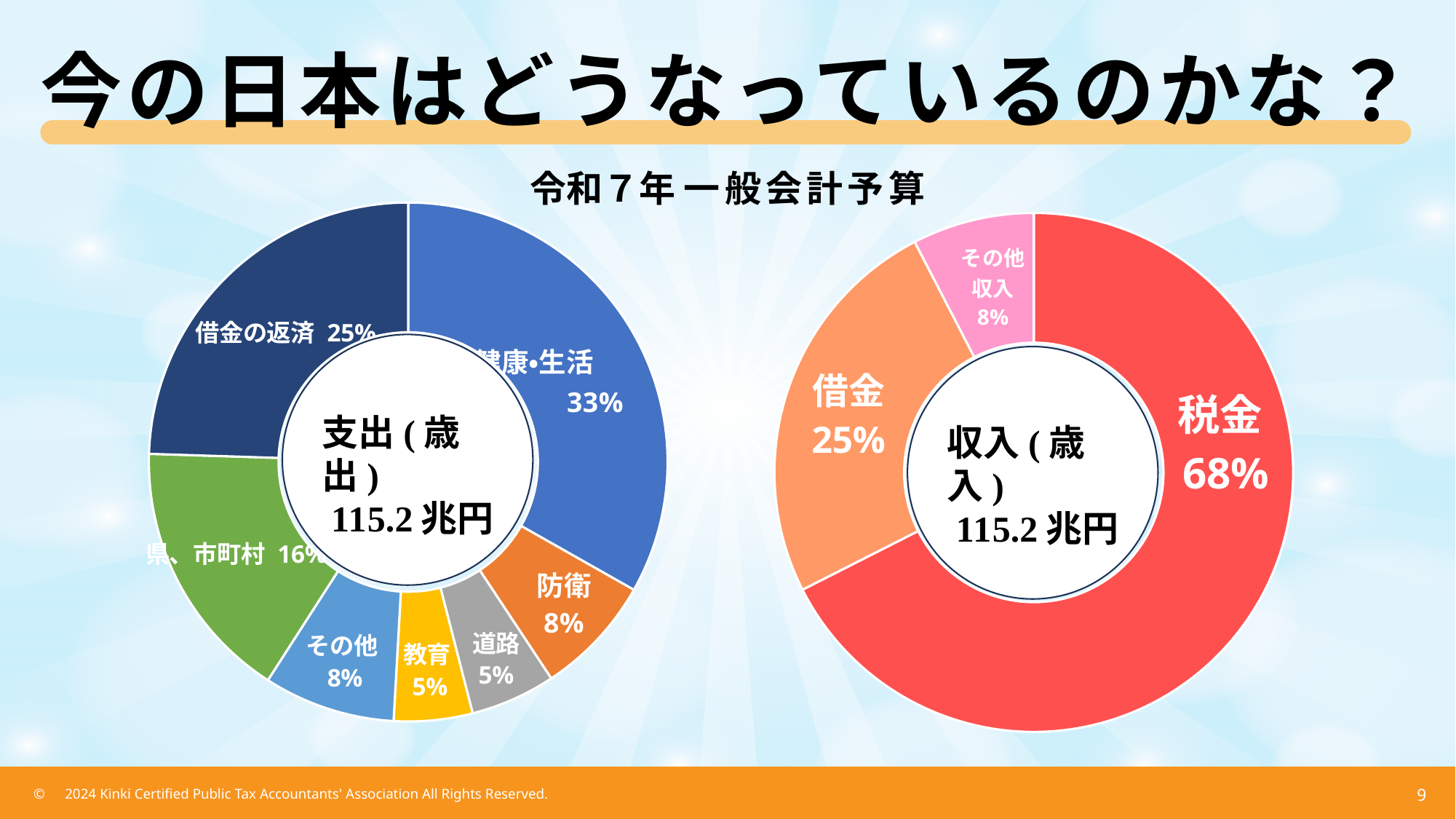
What kind of chart is the left chart (支出(歳出))? Doughnut (pie) chart In the right chart (収入(歳入)), what share is その他収入? 8% In the left chart (支出(歳出)), what share is 県、市町村? 16% In the left chart (支出(歳出)), which category has the largest share? 健康・生活 In the right chart (収入(歳入)), which category has the smallest share? その他収入 In the left chart (支出(歳出)), what share is 健康・生活? 33% In the left chart (支出(歳出)), what is the difference between 借金の返済 and 防衛? 17% In the left chart (支出(歳出)), how many categories are shown? 7 In the right chart (収入(歳入)), what share is 税金? 68% In the right chart (収入(歳入)), how many categories are shown? 3 What total amount is shown in the centre of the right chart (収入(歳入))? 115.2兆円 In the left chart (支出(歳出)), what share is 借金の返済? 25%